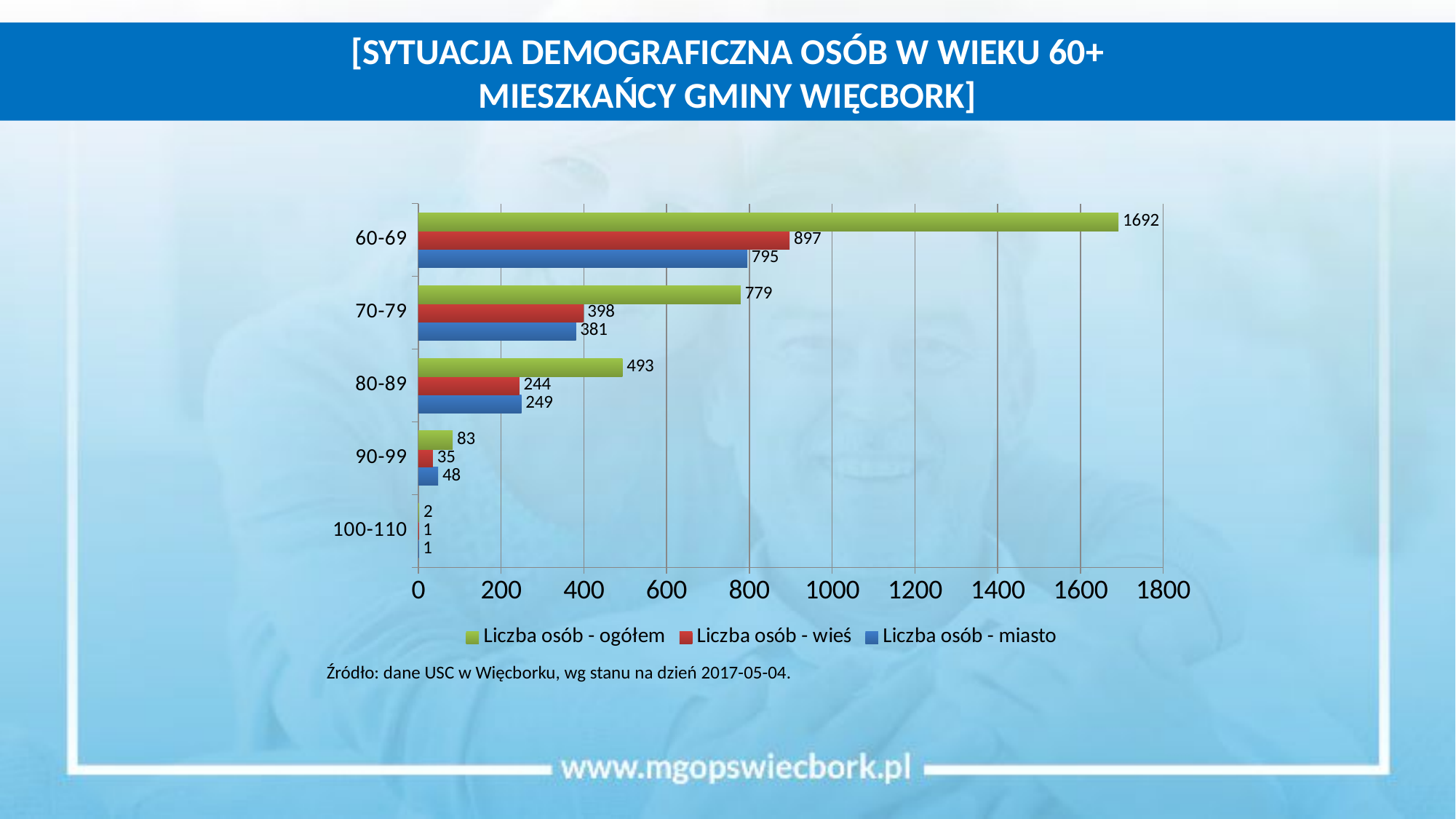
For the 80-89 age group, which is larger: 'Liczba osób - wieś' or 'Liczba osób - miasto'? Liczba osób - miasto How many age groups are shown on the chart? 5 Do the values for 'Liczba osób - ogółem' rise or fall as the age groups go from 60-69 to 100-110? Fall Which age group has the highest value for 'Liczba osób - ogółem'? 60-69 What is the value of 'Liczba osób - miasto' for the 90-99 age group? 48 What is the value of 'Liczba osób - wieś' for the 70-79 age group? 398 How many series does the legend list? 3 What kind of chart is shown on the slide? Bar chart Which age group has the lowest value for 'Liczba osób - miasto'? 100-110 What is the difference between 'Liczba osób - wieś' and 'Liczba osób - miasto' for the 60-69 age group? 102 What is the value of 'Liczba osób - ogółem' for the 60-69 age group? 1692 What colour represents 'Liczba osób - wieś' in the chart? Red